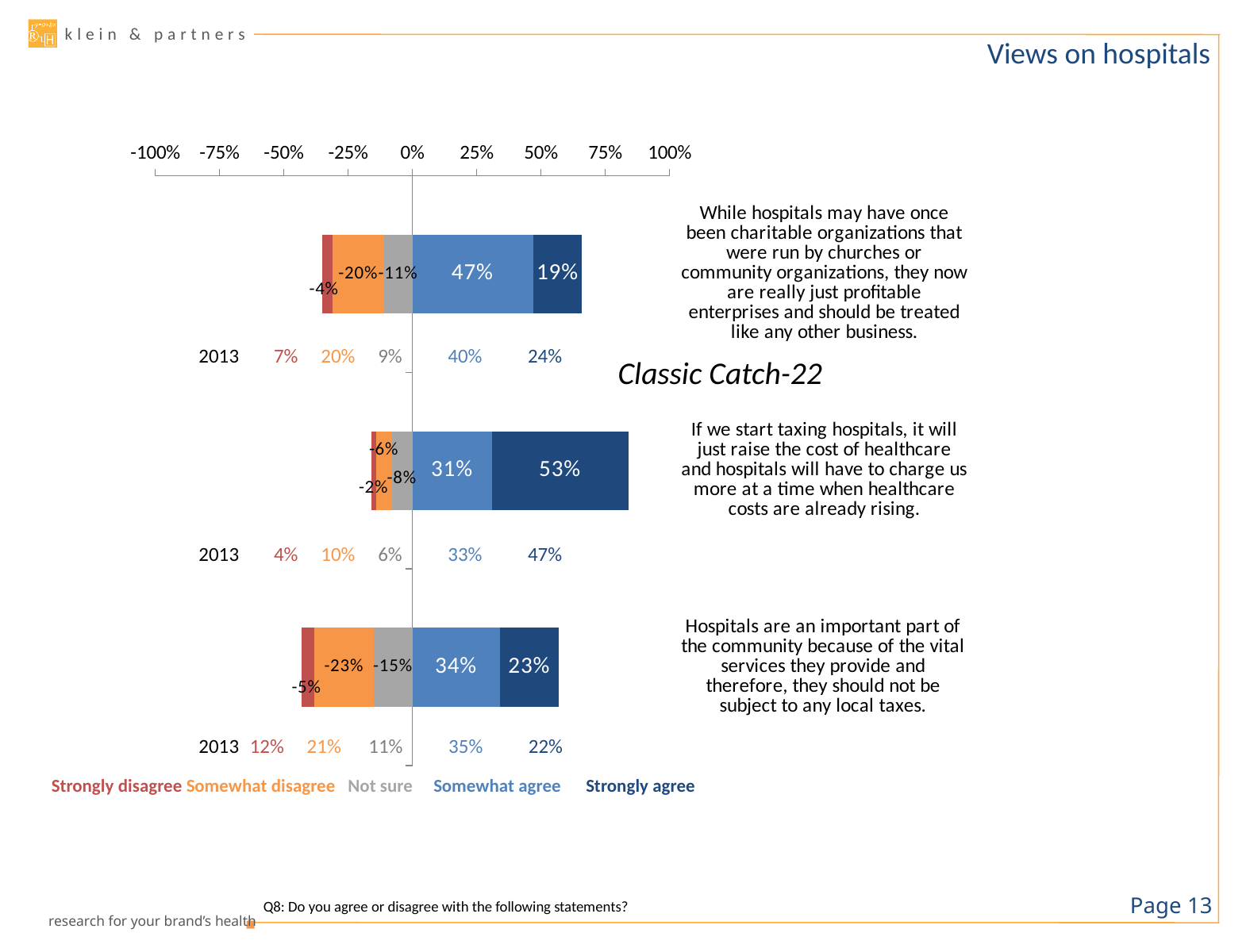
What type of chart is shown on the slide? Stacked bar chart What is the 'Not sure' value shown on the bar for the statement that hospitals should not be subject to any local taxes? -15% Is the 'Somewhat agree' percentage larger for the statement that hospitals are just profitable enterprises or for the statement that hospitals should not be subject to local taxes? Hospitals are just profitable enterprises Which statement has the highest 'Strongly agree' percentage? If we start taxing hospitals, it will just raise the cost of healthcare What percentage strongly agree that if we start taxing hospitals, it will just raise the cost of healthcare? 53% Which legend entry is shown in grey? Not sure What percentage somewhat agree that hospitals are now really just profitable enterprises and should be treated like any other business? 47% What is the difference between the 'Strongly agree' percentage for the taxing-hospitals statement (53%) and its 2013 value (47%)? 6 percentage points How many statements are plotted in the chart? 3 Which statement has the smallest 'Strongly disagree' share on its bar? If we start taxing hospitals, it will just raise the cost of healthcare In 2013, what percentage strongly disagreed that hospitals should not be subject to any local taxes? 12% How many response categories does the legend list? 5